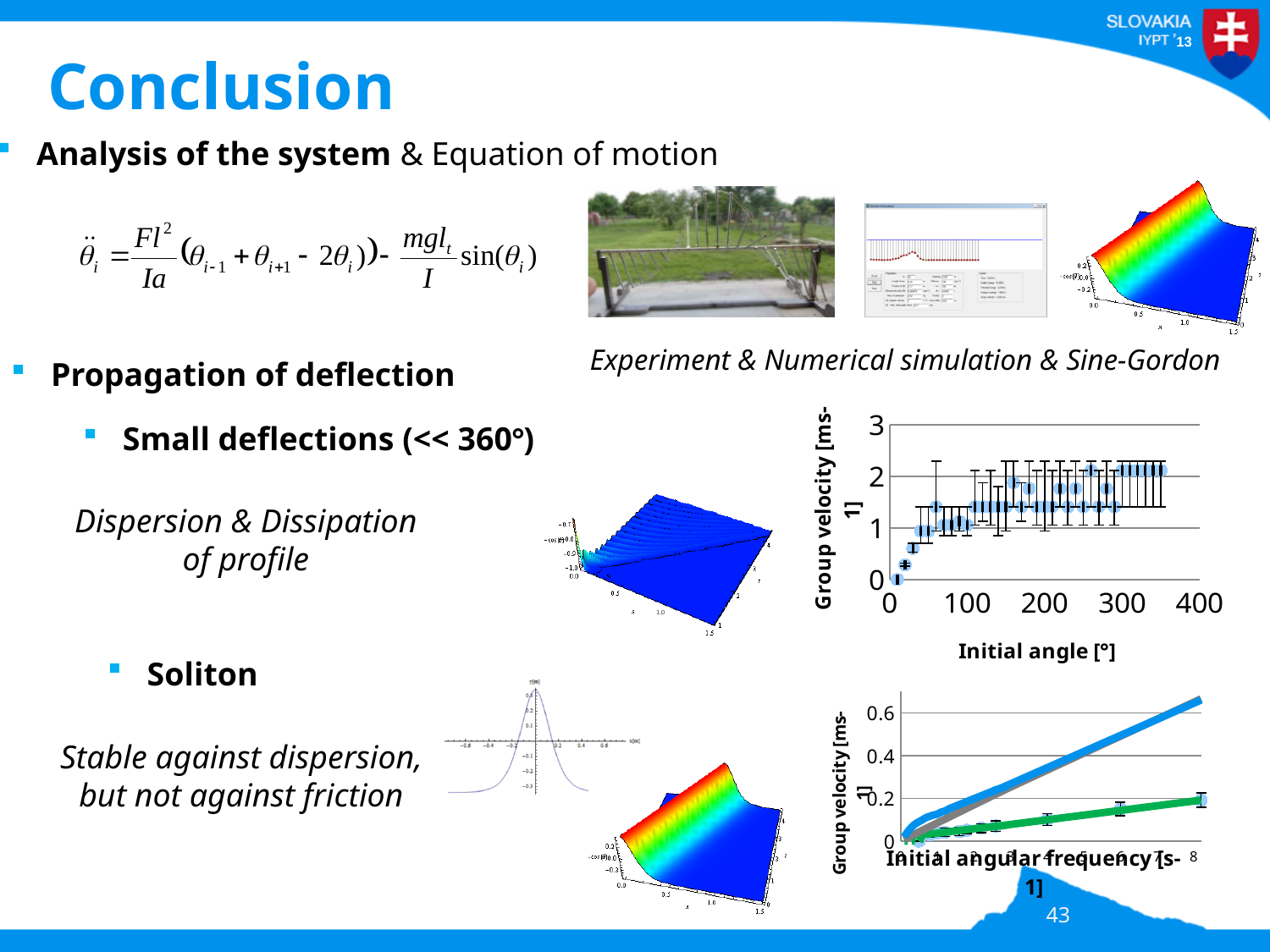
What kind of chart is the lower-right chart with 'Initial angular frequency' on the x axis? line chart In the upper-right chart (Group velocity vs Initial angle), does the group velocity generally rise or fall as the initial angle increases? rise In the upper-right chart (Group velocity vs Initial angle), is the group velocity at an initial angle of about 300° greater or less than 1? greater In the upper-right chart (Group velocity vs Initial angle), what is the highest value shown on the y axis? 3 In the lower-right chart (Group velocity vs Initial angular frequency), do the lines rise or fall as the initial angular frequency increases? rise In the lower-right chart (Group velocity vs Initial angular frequency), is the value of the blue line at the right end of the chart greater or less than 0.4? greater What kind of chart is the upper-right chart with 'Initial angle [°]' on the x axis? scatter chart In the upper-right chart (Group velocity vs Initial angle), what is the label of the x axis? Initial angle [°] In the lower-right chart (Group velocity vs Initial angular frequency), how many lines are plotted? 3 In the upper-right chart (Group velocity vs Initial angle), is the group velocity at the smallest initial angle greater or less than 1? less